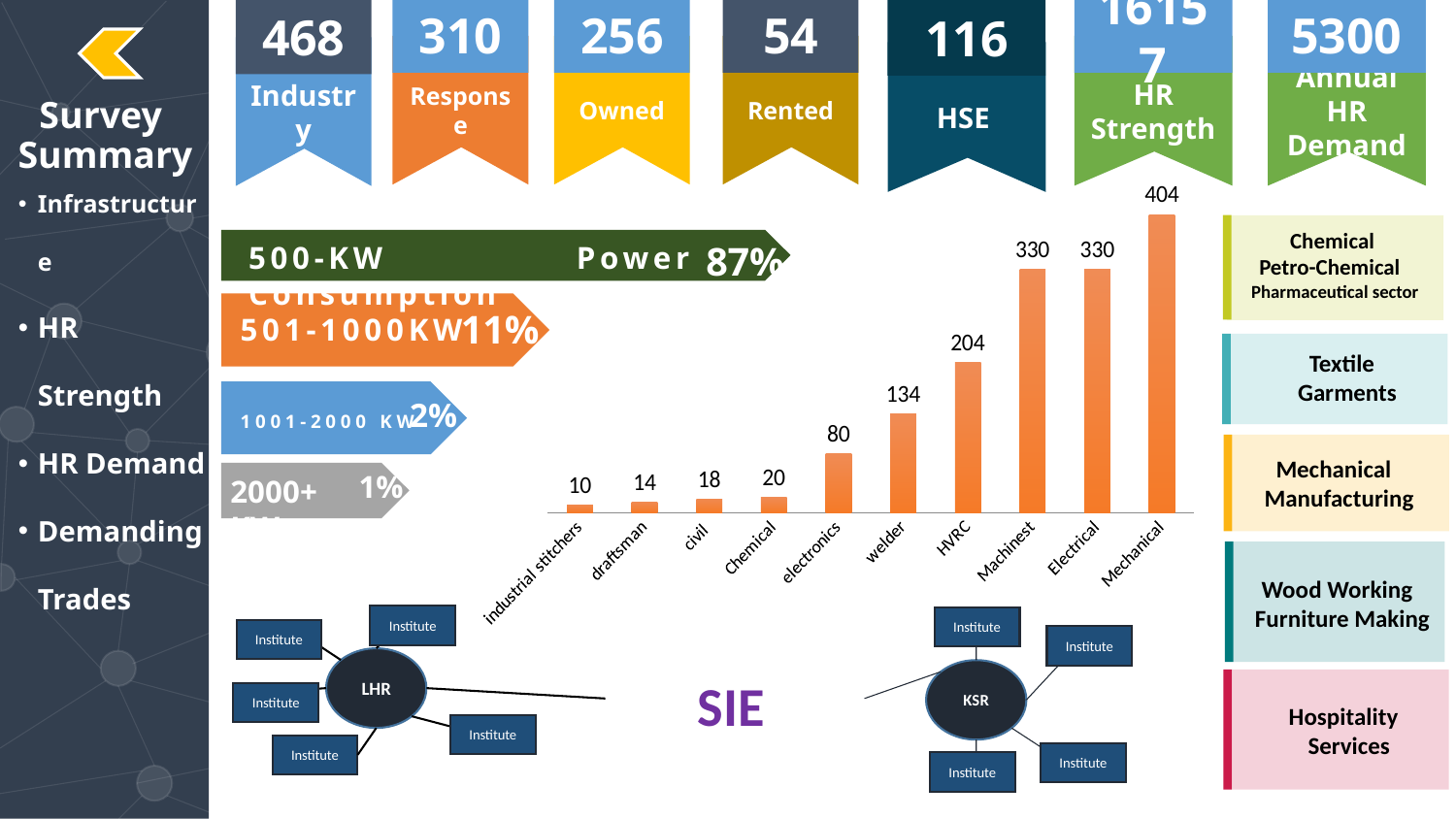
What is the difference between the values for HVRC and welder in the bar chart? 70 What is the value for HVRC in the bar chart? 204 Do the values in the bar chart rise or fall from left to right along the x axis? rise Which is larger in the bar chart, the value for electronics or the value for Chemical? electronics How many categories are shown in the bar chart? 10 What kind of chart is used to show the trades data? bar chart What is the value for welder in the bar chart? 134 Which category has the highest value in the bar chart? Mechanical What is the value for Mechanical in the bar chart? 404 What is the difference between the values for Mechanical and Electrical in the bar chart? 74 What is the value for electronics in the bar chart? 80 Which category has the lowest value in the bar chart? industrial stitchers